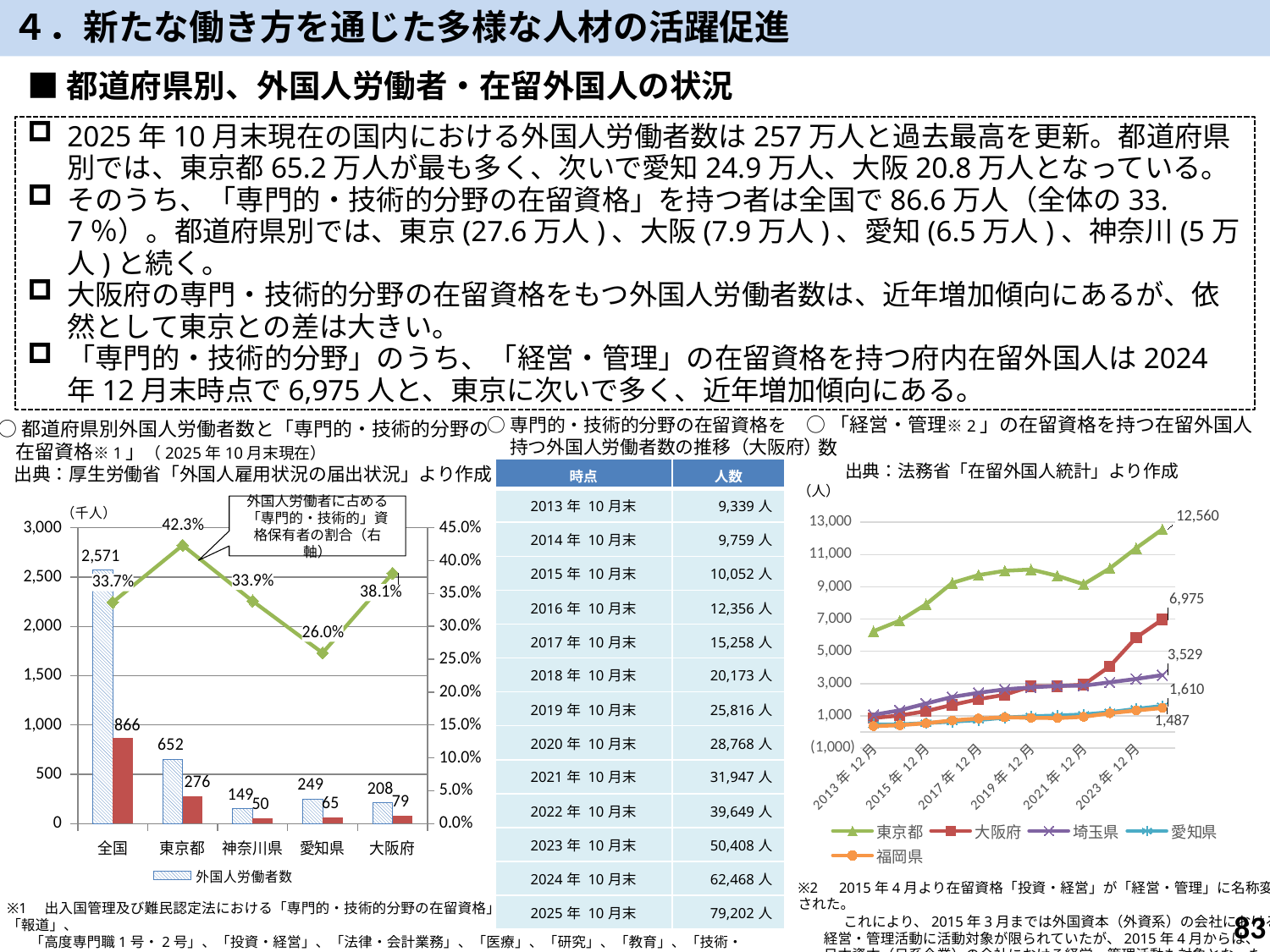
In the left bar chart, what percentage is shown on the line for 大阪府? 38.1% In the right line chart, what is the difference between the latest labelled values for 東京都 and 大阪府? 5,585 How many series does the legend of the right line chart (経営・管理の在留資格を持つ在留外国人数) list? 5 In the left bar chart, what is the difference between the 外国人労働者数 values for 愛知県 and 大阪府? 41 How many categories are shown on the x axis of the left bar chart? 5 What kind of chart is the chart on the right of the slide? line chart In the left bar chart, which category has the highest percentage on the line (right axis)? 東京都 In the left bar chart (都道府県別外国人労働者数), what is the 外国人労働者数 value for 全国? 2,571 In the left bar chart, which has a larger 外国人労働者数 value, 神奈川県 or 愛知県? 愛知県 In the right line chart, what is the latest labelled value for 東京都? 12,560 In the left bar chart, what is the value of the red bar (専門的・技術的分野の在留資格 holders) for 東京都? 276 In the left bar chart, which category has the lowest percentage on the line (right axis)? 愛知県